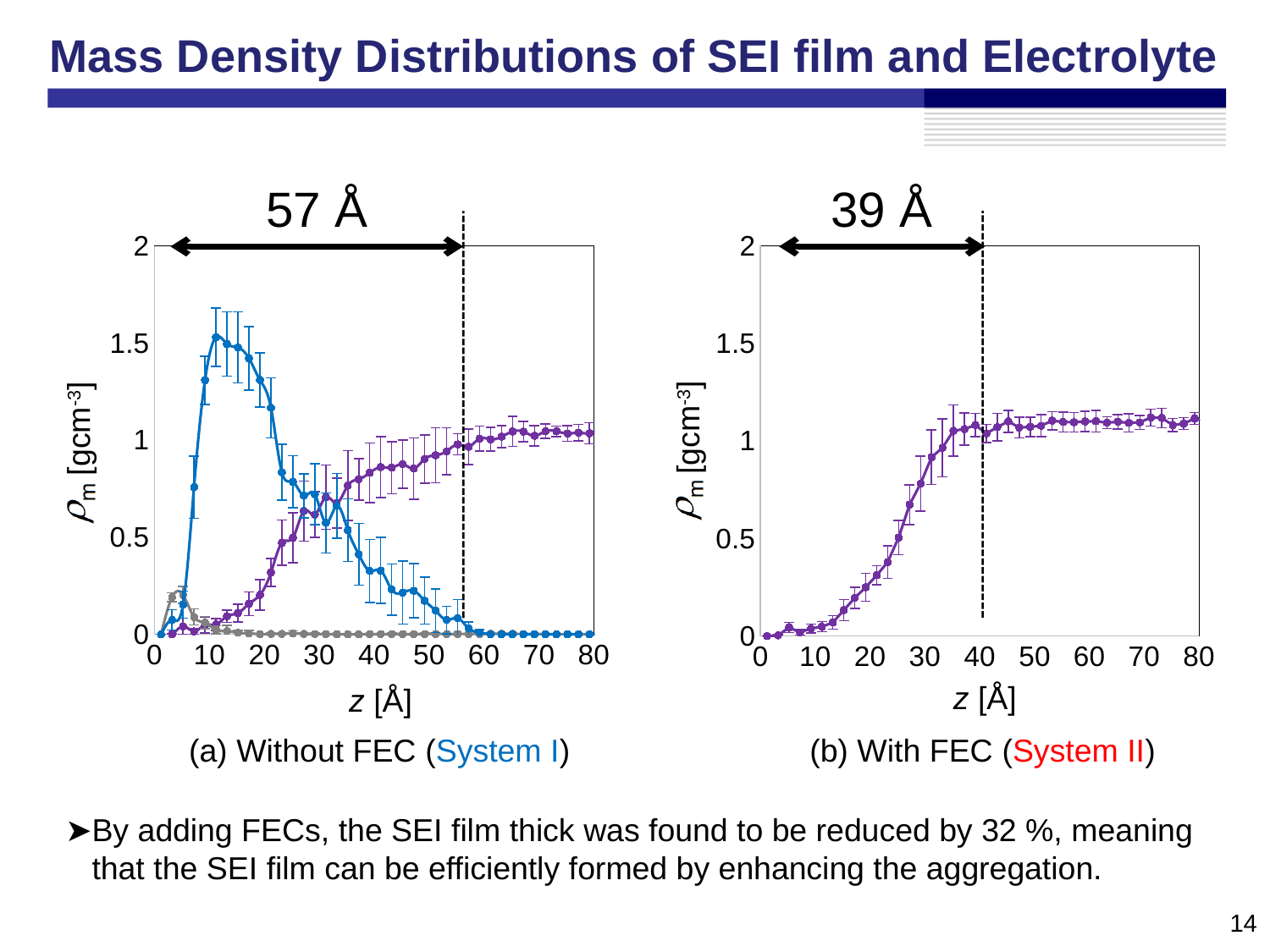
What kind of chart is chart (b) With FEC (System II)? line chart In chart (a) Without FEC (System I), is the value of the blue series at z = 70 Å greater or less than 0.5? less In chart (b) With FEC (System II), what SEI film thickness is annotated above the plot? 39 Å What is the label of the x axis in chart (a) Without FEC (System I)? z [Å] Which chart shows the larger annotated thickness, (a) Without FEC or (b) With FEC? (a) Without FEC What is the difference between the annotated thickness in chart (a) Without FEC and the annotated thickness in chart (b) With FEC? 18 Å In chart (b) With FEC (System II), is the value of the purple series at z = 20 Å greater or less than 0.5? less In chart (b) With FEC (System II), is the value of the purple series at z = 60 Å greater or less than 0.5? greater In chart (a) Without FEC (System I), what SEI film thickness is annotated above the plot? 57 Å What kind of chart is chart (a) Without FEC (System I)? line chart In chart (b) With FEC (System II), does the purple series generally rise or fall as z increases? rise